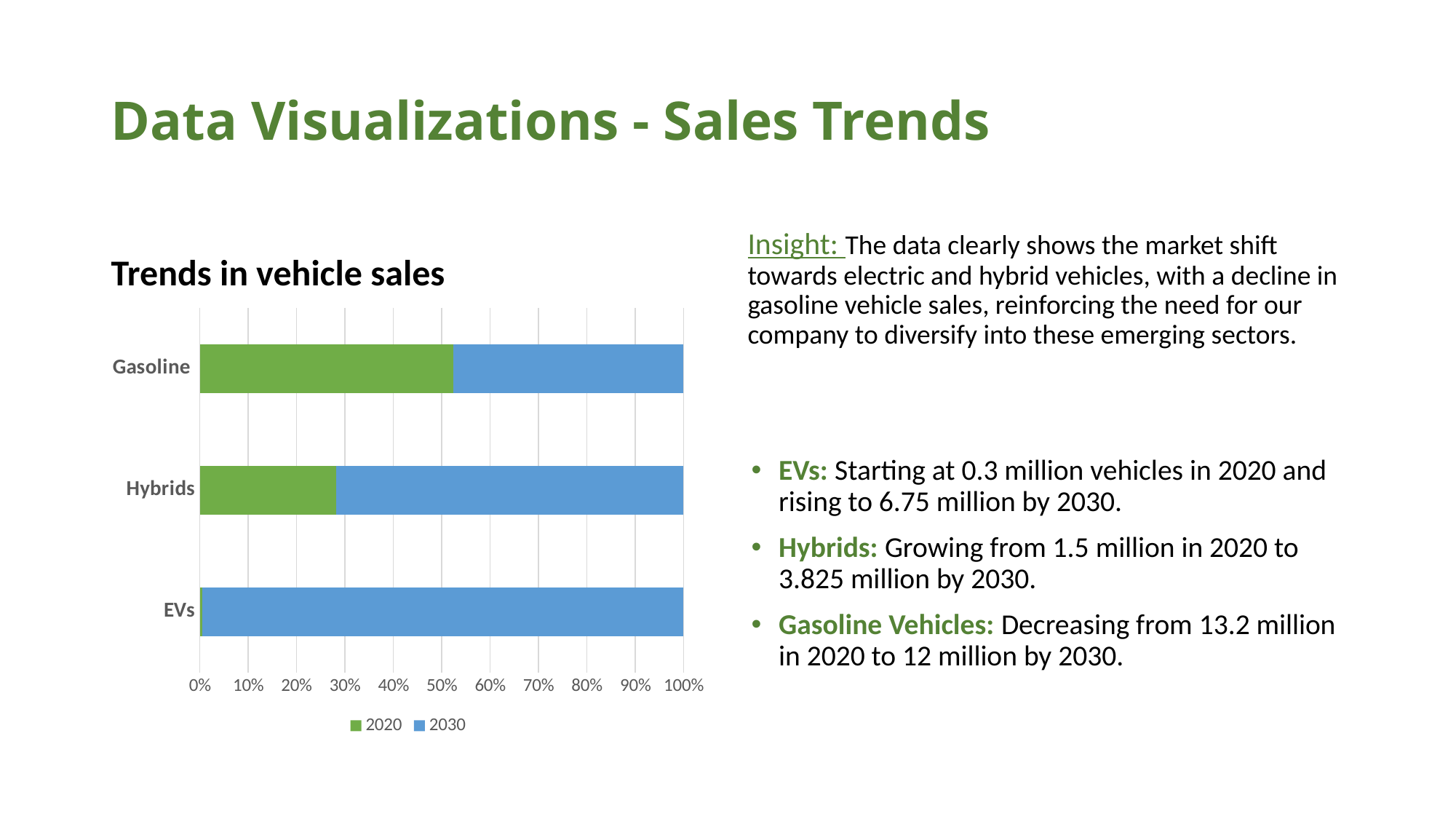
What kind of chart is shown on the slide? Stacked bar chart How many vehicle categories are plotted on the chart? 3 Which colour represents the 2030 series in the chart? Blue Is the 2020 share of the Gasoline bar greater or less than 40%? greater Which category has the smallest 2020 share of its bar? EVs Which category has the largest 2020 share of its bar? Gasoline Is the 2020 share of the EVs bar greater or less than 10%? less What percentage does each stacked bar total on the x axis? 100% For Hybrids, which series takes up the larger share of the bar, 2020 or 2030? 2030 How many series does the chart legend list? 2 What is the title of the chart? Trends in vehicle sales Is the 2020 share of the Hybrids bar greater or less than 40%? less